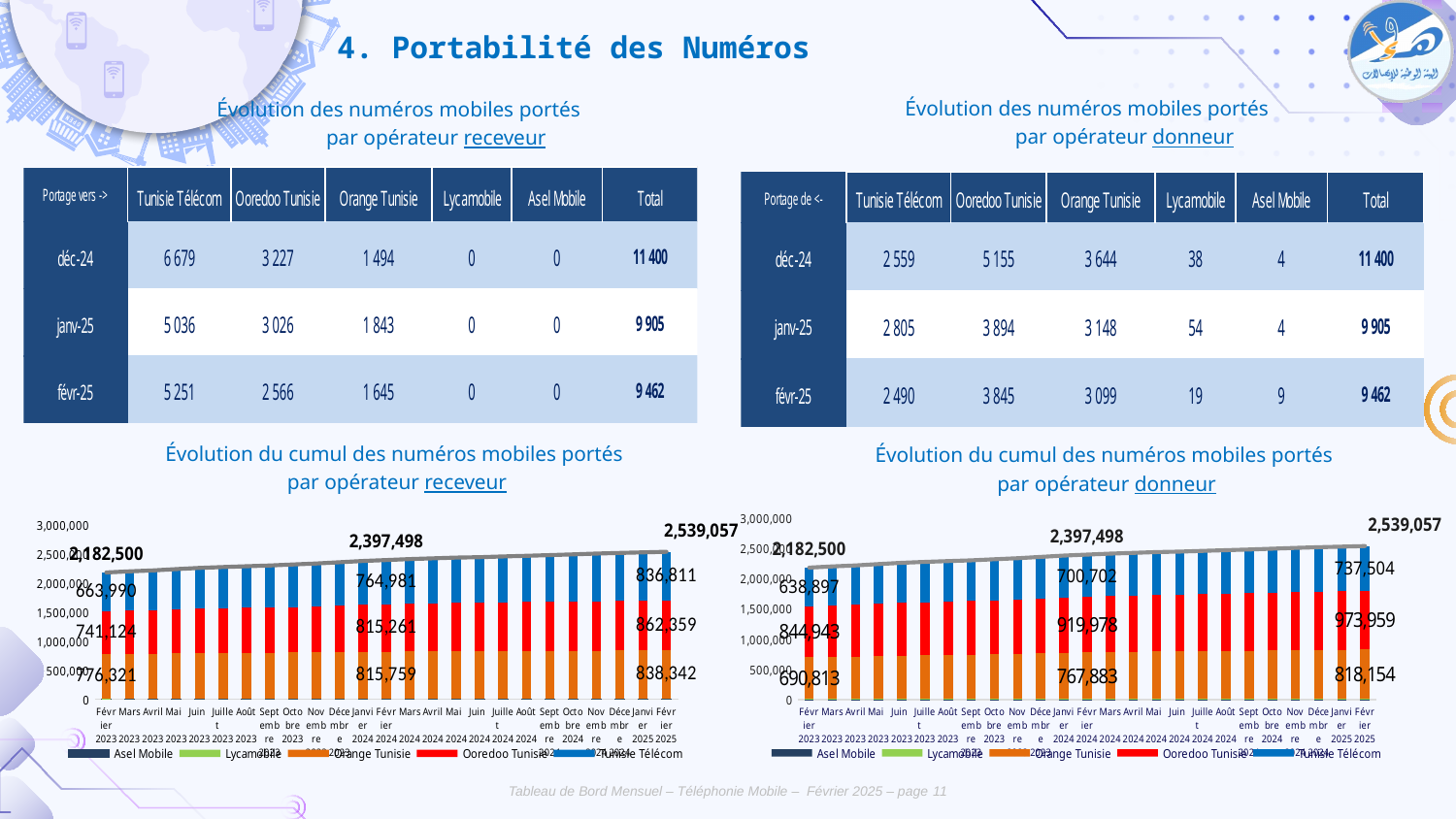
In the 'par opérateur receveur' cumulative chart, what is the Tunisie Télécom value labelled for Février 2025? 836,811 In the 'par opérateur donneur' cumulative chart, what is the Orange Tunisie value labelled for Février 2024? 767,883 In the 'par opérateur receveur' cumulative chart, what is the difference between the Février 2025 total and the Février 2024 total? 141,559 In the 'par opérateur receveur' cumulative chart, by how much did the Tunisie Télécom value increase from Février 2024 to Février 2025? 71,830 In the 'par opérateur donneur' cumulative chart, do the bar totals rise or fall from Février 2023 to Février 2025? Rise In the 'par opérateur donneur' cumulative chart, what is the total labelled for Février 2023? 2,182,500 In the 'par opérateur donneur' cumulative chart, what is the Ooredoo Tunisie value labelled for Février 2025? 973,959 What kind of chart is the 'Évolution du cumul des numéros mobiles portés par opérateur receveur' chart? Stacked bar chart In the 'par opérateur donneur' cumulative chart for Février 2025, which is larger: Ooredoo Tunisie or Tunisie Télécom? Ooredoo Tunisie In the 'par opérateur receveur' cumulative chart, is the total for Février 2024 greater or less than 2,000,000? greater How many series does the legend of the 'Évolution du cumul des numéros mobiles portés par opérateur donneur' chart list? 5 In the 'par opérateur receveur' cumulative chart, what is the total labelled for Février 2025? 2,539,057